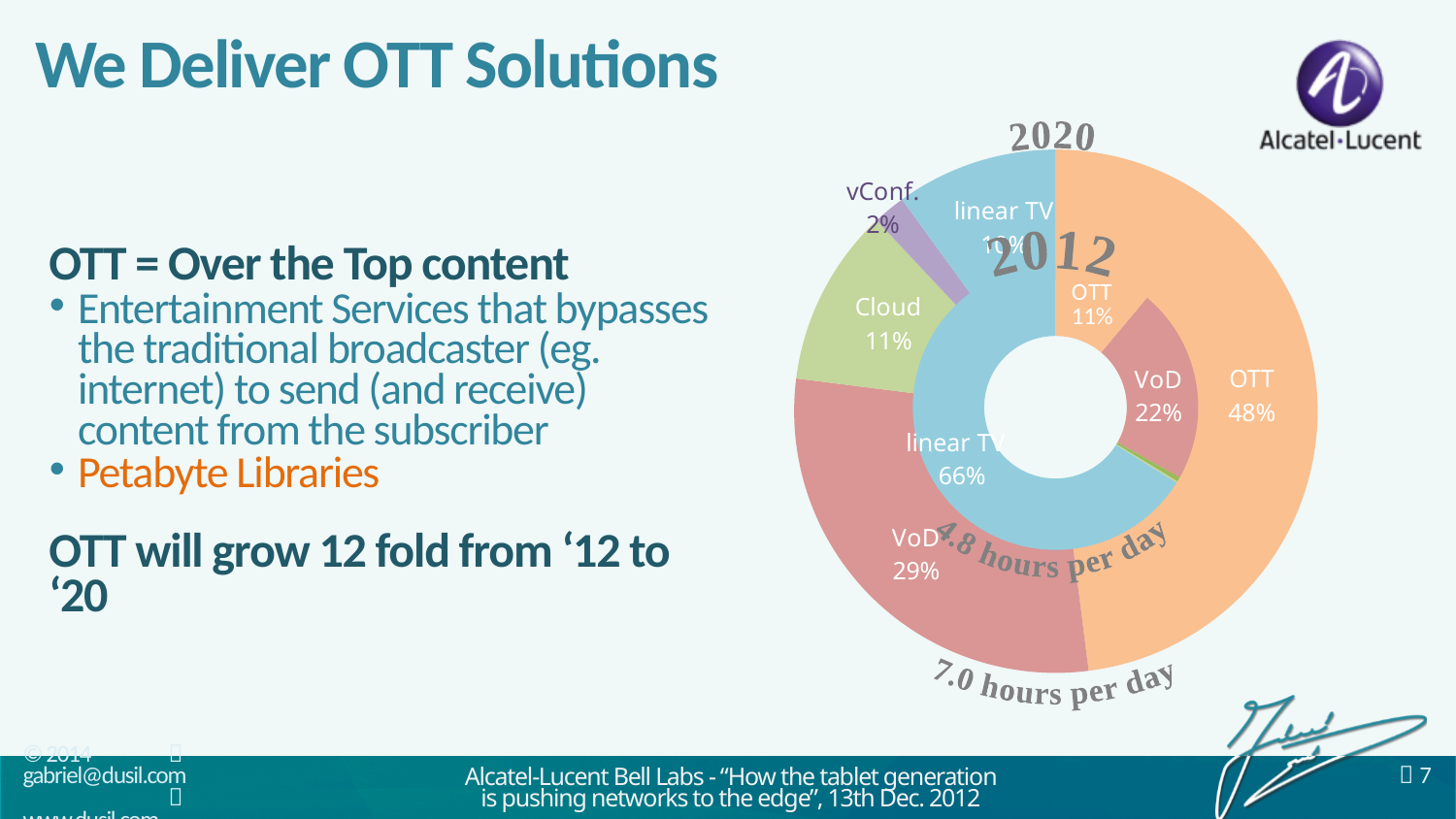
In the 2020 ring, what share does VoD have? 29% In the 2020 ring, what share does OTT have? 48% In the 2012 ring, what share does VoD have? 22% In the 2020 ring, what share does vConf. have? 2% How many hours per day are shown for 2020? 7.0 hours per day In the 2012 ring, what share does OTT have? 11% Which category has the largest share in the 2012 ring? linear TV How many percentage points higher is OTT's share in 2020 than in 2012? 37 In the 2020 ring, what share does Cloud have? 11% Which category has the smallest share in the 2020 ring? vConf. In the 2012 ring, what share does linear TV have? 66% What kind of chart is shown on the slide? doughnut chart